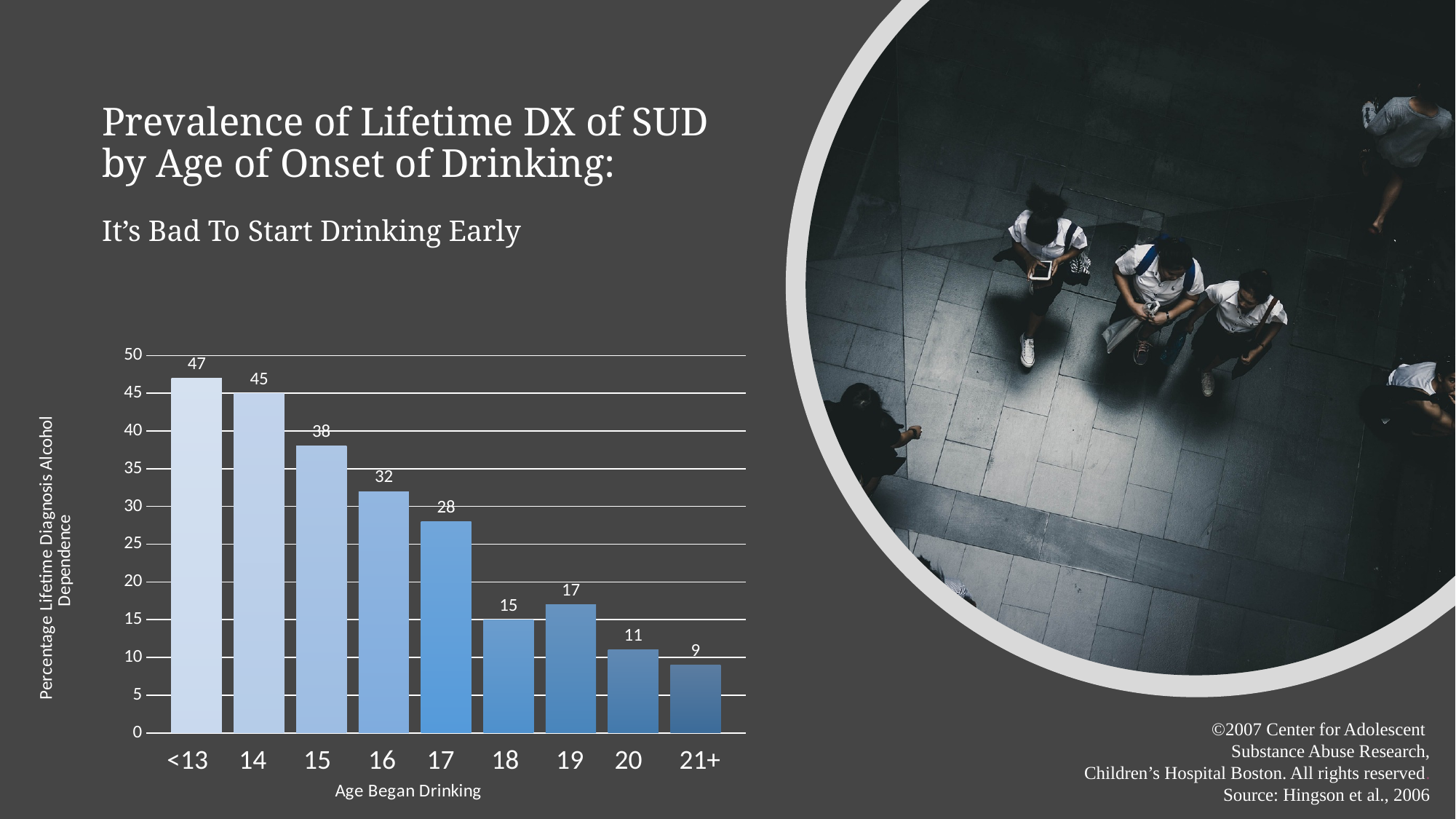
Which has a higher value, age 18 or age 19? 19 What is the value shown for the 21+ age group? 9 What is the difference between the values for age 14 and age 15? 7 What is the label of the x axis? Age Began Drinking Is the value for age 17 greater or less than 25? greater How many age categories are shown on the x axis? 9 Which age of onset category has the highest percentage? <13 What is the difference between the values for <13 and 21+? 38 What kind of chart is shown on the slide? Bar chart What is the value shown for the <13 age group? 47 Which age of onset category has the lowest percentage? 21+ What is the percentage with lifetime diagnosis of alcohol dependence for those who began drinking at age 16? 32